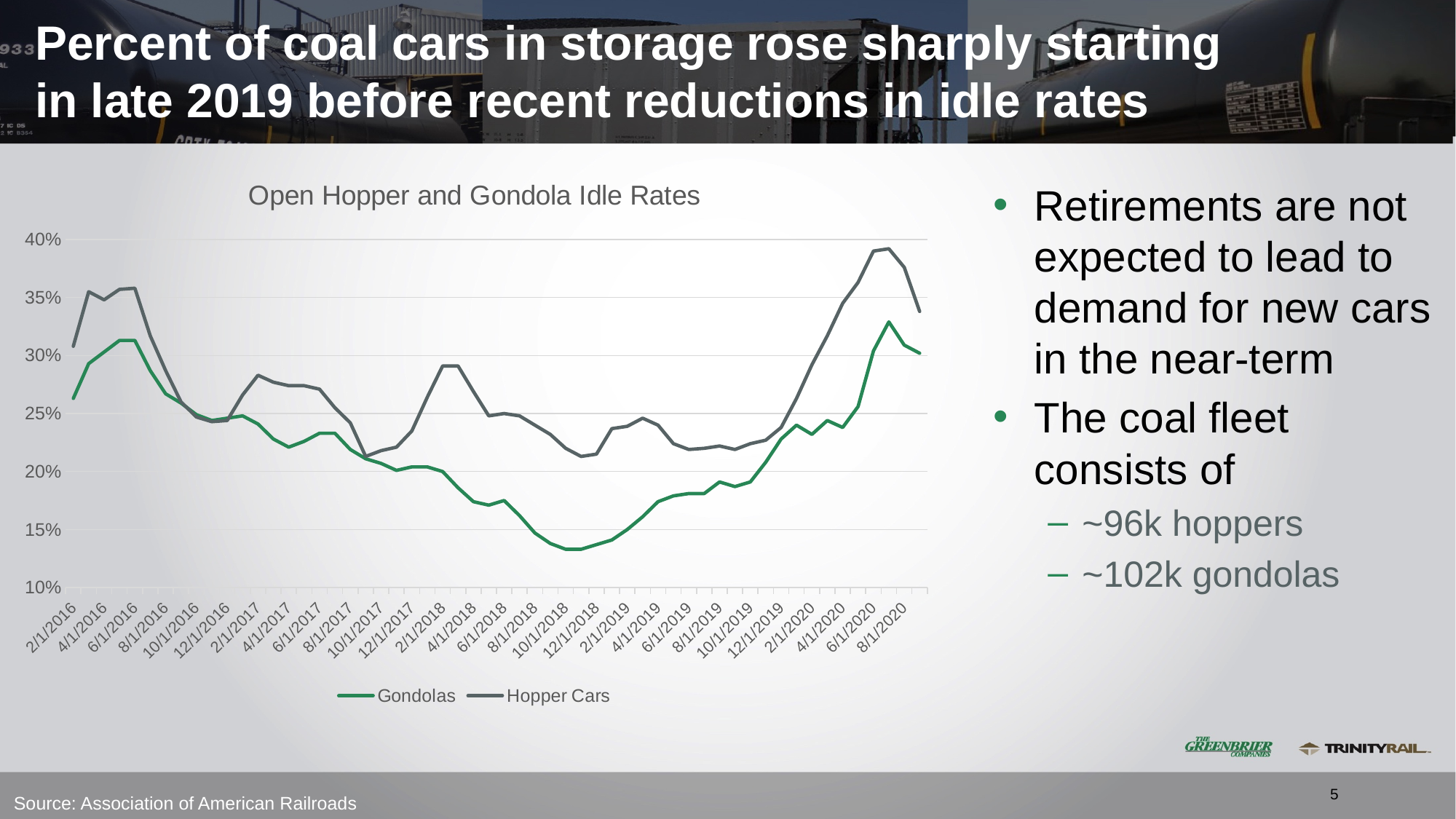
What kind of chart is shown on the slide? line chart Which series reaches the highest idle rate anywhere on the chart? Hopper Cars Which colour is used for the Gondolas line? green At 2/1/2018, which series has the higher idle rate, Gondolas or Hopper Cars? Hopper Cars How many series does the legend list? 2 Is the Gondolas value at 10/1/2018 greater or less than 15%? less Is the Hopper Cars value at 6/1/2020 greater or less than 35%? greater What is the title of the chart? Open Hopper and Gondola Idle Rates Does the Hopper Cars line rise or fall between 12/1/2019 and 6/1/2020? rise Does the Gondolas line rise or fall between 6/1/2016 and 10/1/2018? fall Is the Hopper Cars value at 2/1/2016 greater or less than 30%? greater